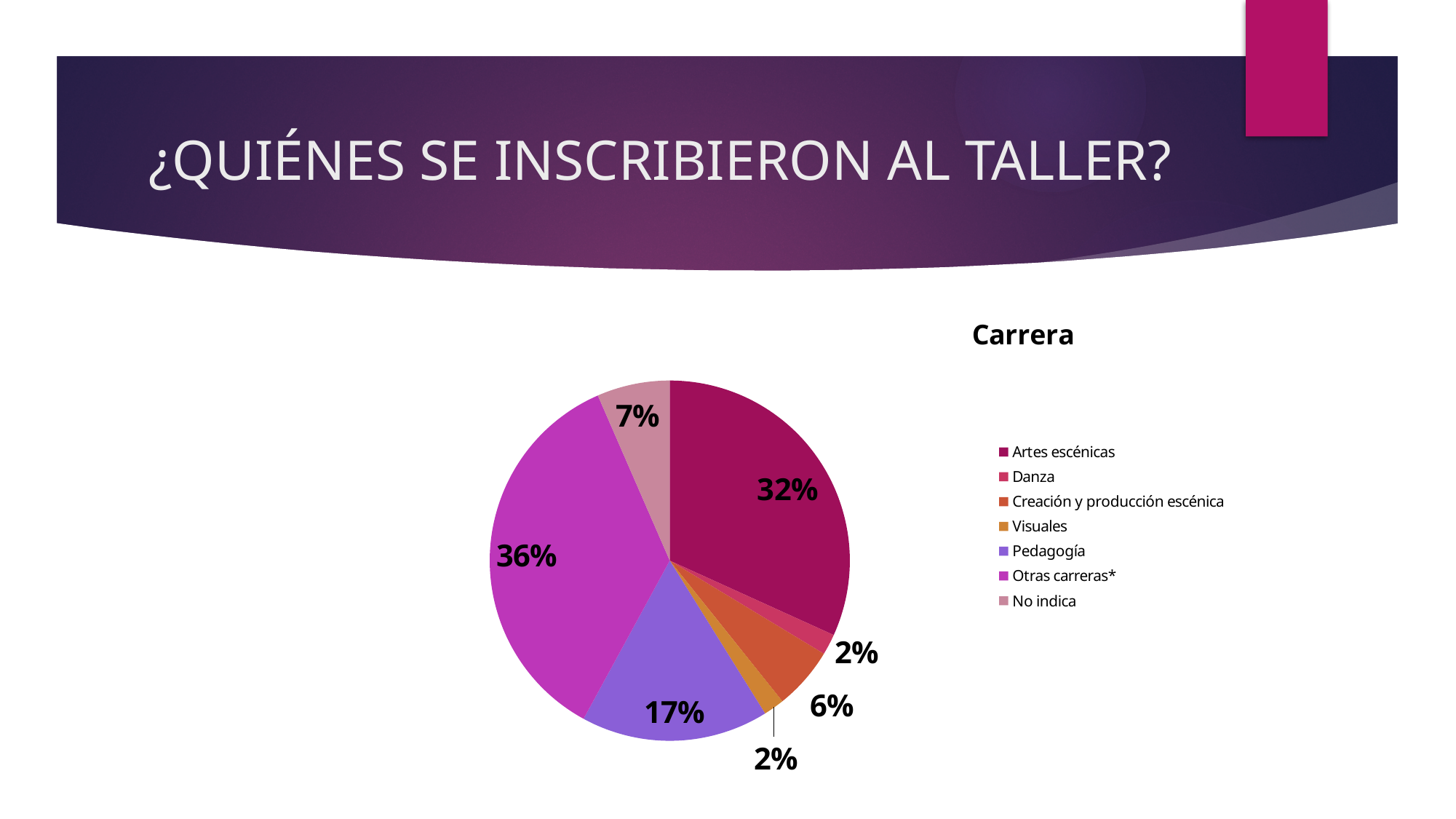
Which category has the largest slice of the pie? Otras carreras* How many categories does the legend of the pie chart list? 7 Which is larger, the slice for Pedagogía or the slice for No indica? Pedagogía What is the title of the chart? Carrera What share of the pie does Artes escénicas represent? 32% What type of chart is shown on the slide? pie chart What share of the pie does No indica represent? 7% What share of the pie does Creación y producción escénica represent? 6% What is the difference in percentage points between Pedagogía and Creación y producción escénica? 11% What is the difference in percentage points between Otras carreras* and Artes escénicas? 4%